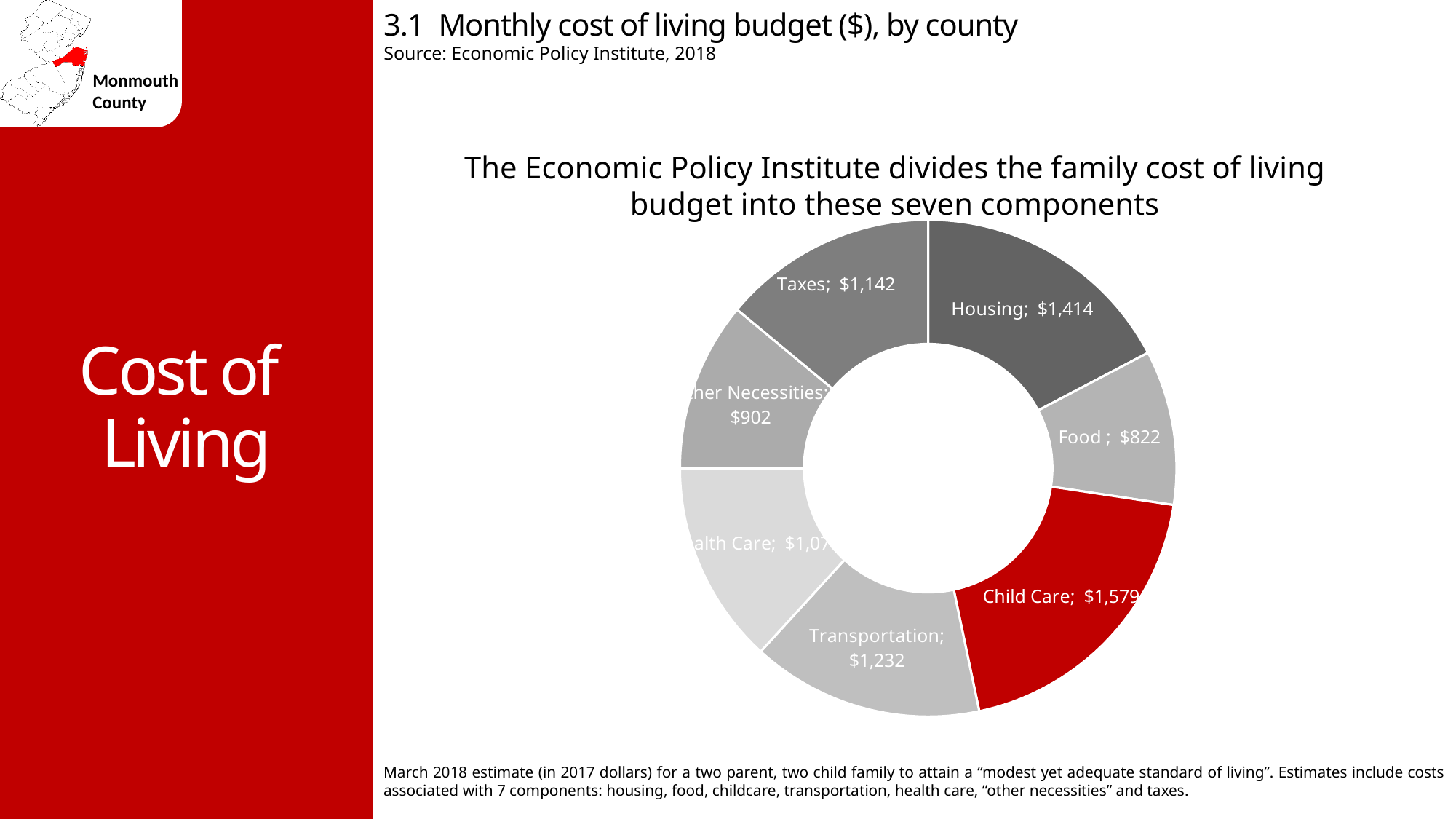
What is the difference between the Child Care and Housing monthly costs? $165 What is the monthly cost for Taxes shown on the chart? $1,142 Which component has the highest monthly cost? Child Care Which component has the lowest monthly cost? Food How many components does the chart divide the cost of living budget into? 7 What is the monthly cost for Transportation shown on the chart? $1,232 What is the monthly cost for Child Care shown on the chart? $1,579 Which is larger, the monthly cost for Housing or for Taxes? Housing How much more is the monthly cost of Housing than Food? $592 What is the monthly cost for Food shown on the chart? $822 What is the monthly cost for Housing shown on the chart? $1,414 What kind of chart is shown on the slide? Doughnut (pie) chart